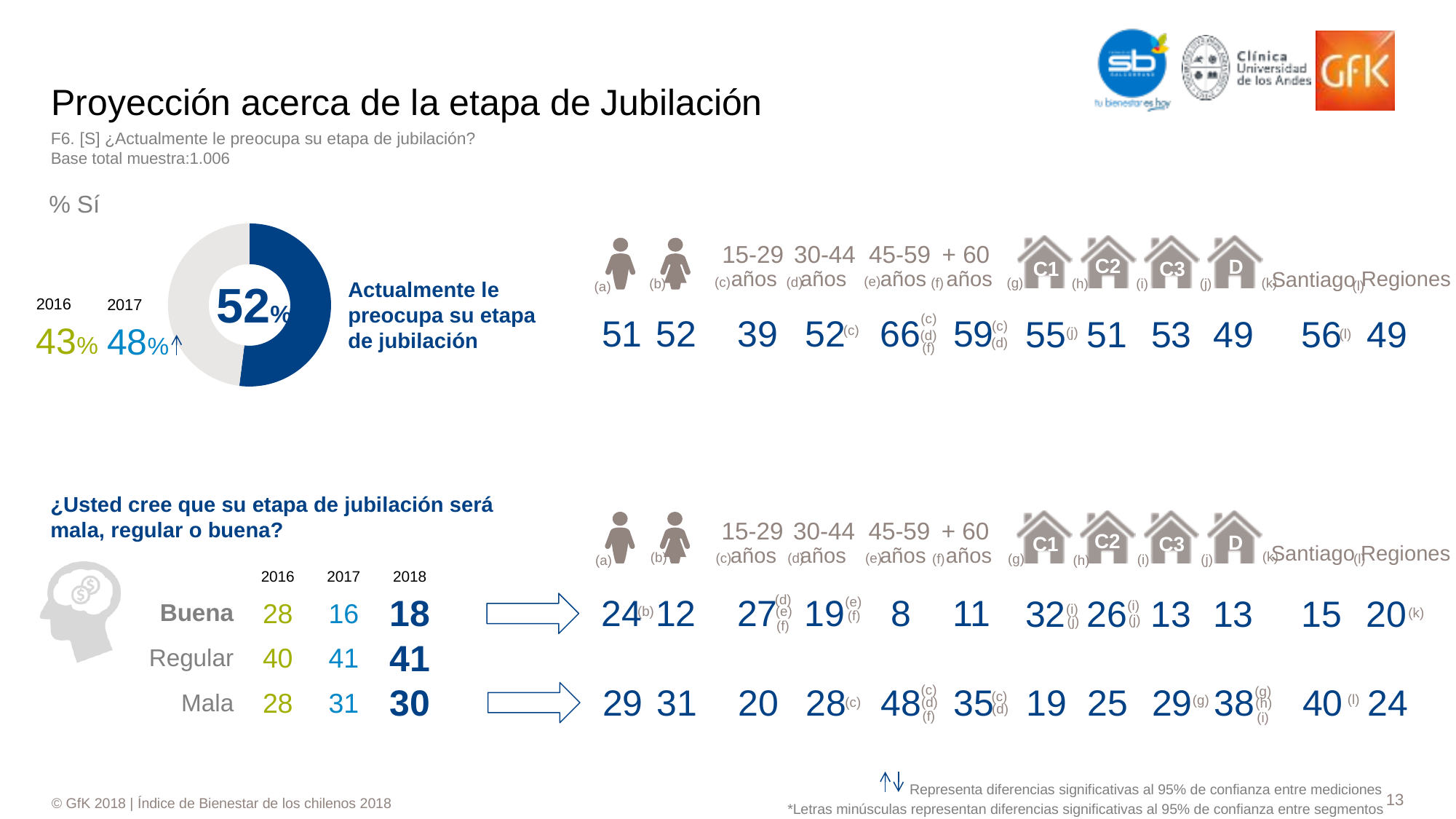
What share of the donut chart does the grey slice represent? 48% What share of the donut chart does the dark blue slice represent? 52% What is the difference in percentage points between the 2017 value (48%) and the 2016 value (43%) next to the donut chart? 5 How many slices does the donut chart have? 2 Did the % Sí for 'Actualmente le preocupa su etapa de jubilación' rise or fall from 2016 to 2018? Rise What was the % Sí value for 2017 shown next to the donut chart? 48% What is the difference in percentage points between the 2018 donut value (52%) and the 2017 value (48%)? 4 What percentage is shown in the centre of the donut chart? 52% Which year has the larger % Sí value, 2016 or 2017? 2017 What statement does the donut chart's 52% refer to? Actualmente le preocupa su etapa de jubilación What was the % Sí value for 2016 shown next to the donut chart? 43% What kind of chart is used to show the % Sí for 'Actualmente le preocupa su etapa de jubilación'? Donut (pie) chart